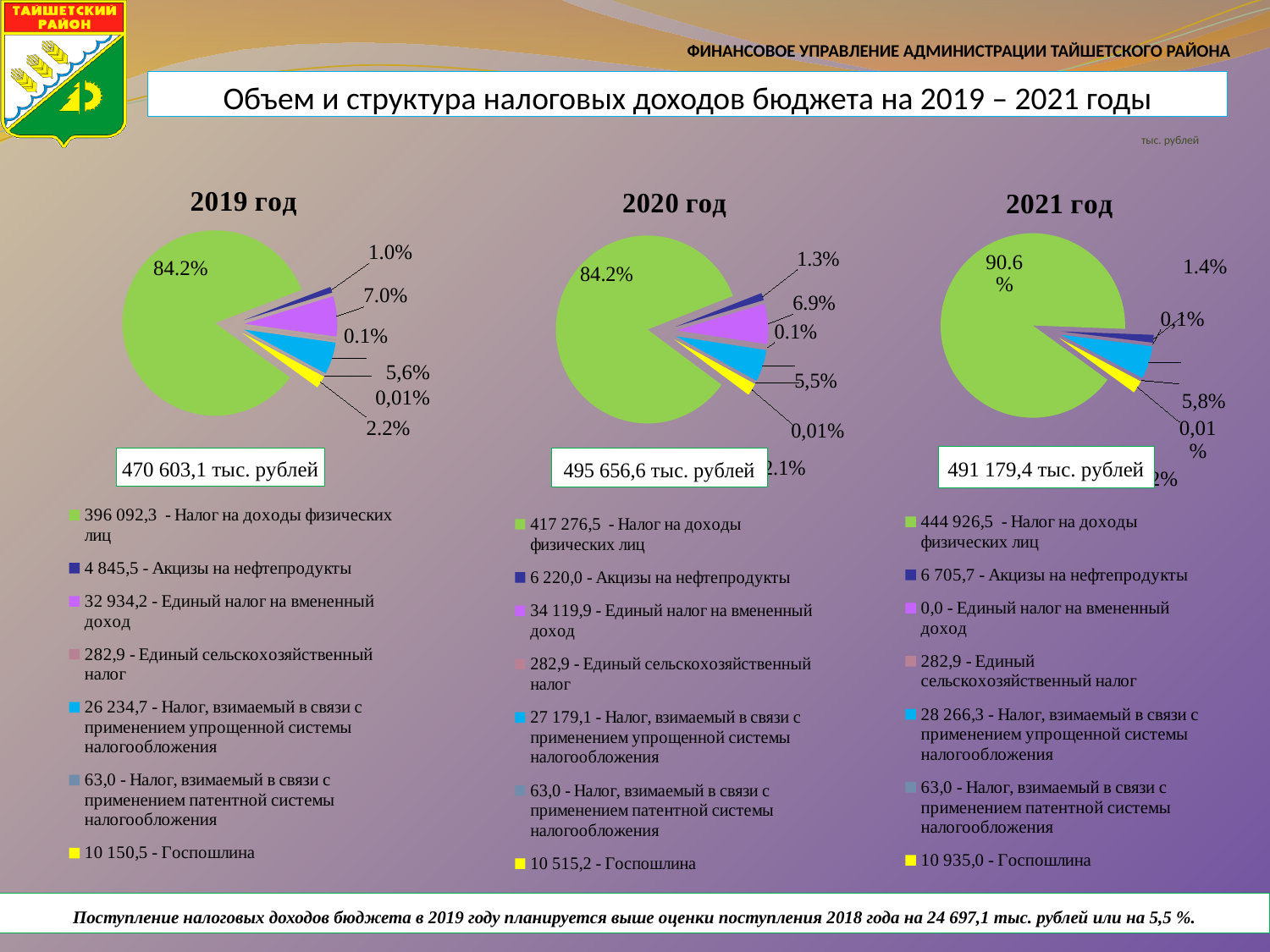
In the 2019 год chart, which category has the smallest value? Налог, взимаемый в связи с применением патентной системы налогообложения By how much does the value for Налог на доходы физических лиц in the 2021 год chart exceed the value in the 2019 год chart? 48 834,2 In the 2019 год chart, what share of the pie does Налог на доходы физических лиц take? 84.2% In the 2021 год chart, which category has the largest slice? Налог на доходы физических лиц In the 2020 год chart, which is larger: Госпошлина or Акцизы на нефтепродукты? Госпошлина In the 2021 год chart, what share of the pie does Налог на доходы физических лиц take? 90.6% In the 2021 год chart, what is the value for Единый налог на вмененный доход? 0,0 What total amount is shown below the 2020 год chart? 495 656,6 тыс. рублей In the 2021 год chart, what is the value for Акцизы на нефтепродукты? 6 705,7 What kind of chart is used for the 2019 год, 2020 год and 2021 год data? Pie chart In the 2019 год chart, what is the value for Налог на доходы физических лиц? 396 092,3 How many categories does the legend of the 2019 год chart list? 7